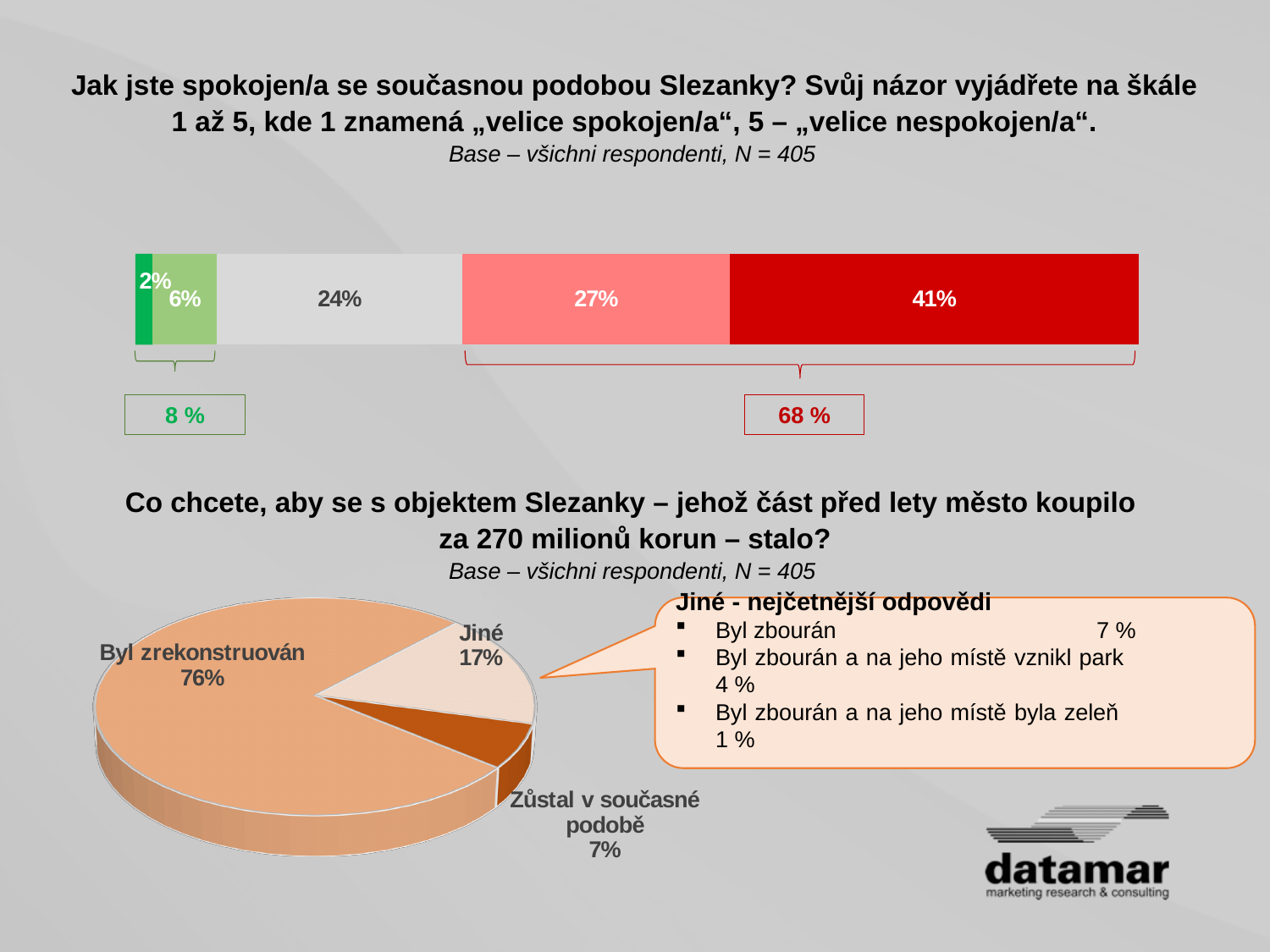
In the pie chart at the bottom of the slide, what share of respondents chose "Byl zrekonstruován"? 76% In the stacked bar chart at the top of the slide, how many segments does the bar have? 5 In the stacked bar chart at the top of the slide, what is the value of the largest segment (the dark red one on the right)? 41% In the pie chart at the bottom of the slide, how many slices are there? 3 In the stacked bar chart at the top of the slide, what is the value of the smallest segment (the dark green one on the far left)? 2% In the stacked bar chart at the top of the slide, what combined value is shown in the red box under the two red segments? 68 % In the pie chart at the bottom of the slide, what share of respondents chose "Zůstal v současné podobě"? 7% In the pie chart at the bottom of the slide, what share is labelled "Jiné"? 17% What kind of chart is shown at the bottom of the slide? Pie chart In the pie chart at the bottom of the slide, which slice is the largest? Byl zrekonstruován In the pie chart at the bottom of the slide, which slice is the smallest? Zůstal v současné podobě In the pie chart at the bottom of the slide, what is the difference in percentage points between "Byl zrekonstruován" and "Jiné"? 59